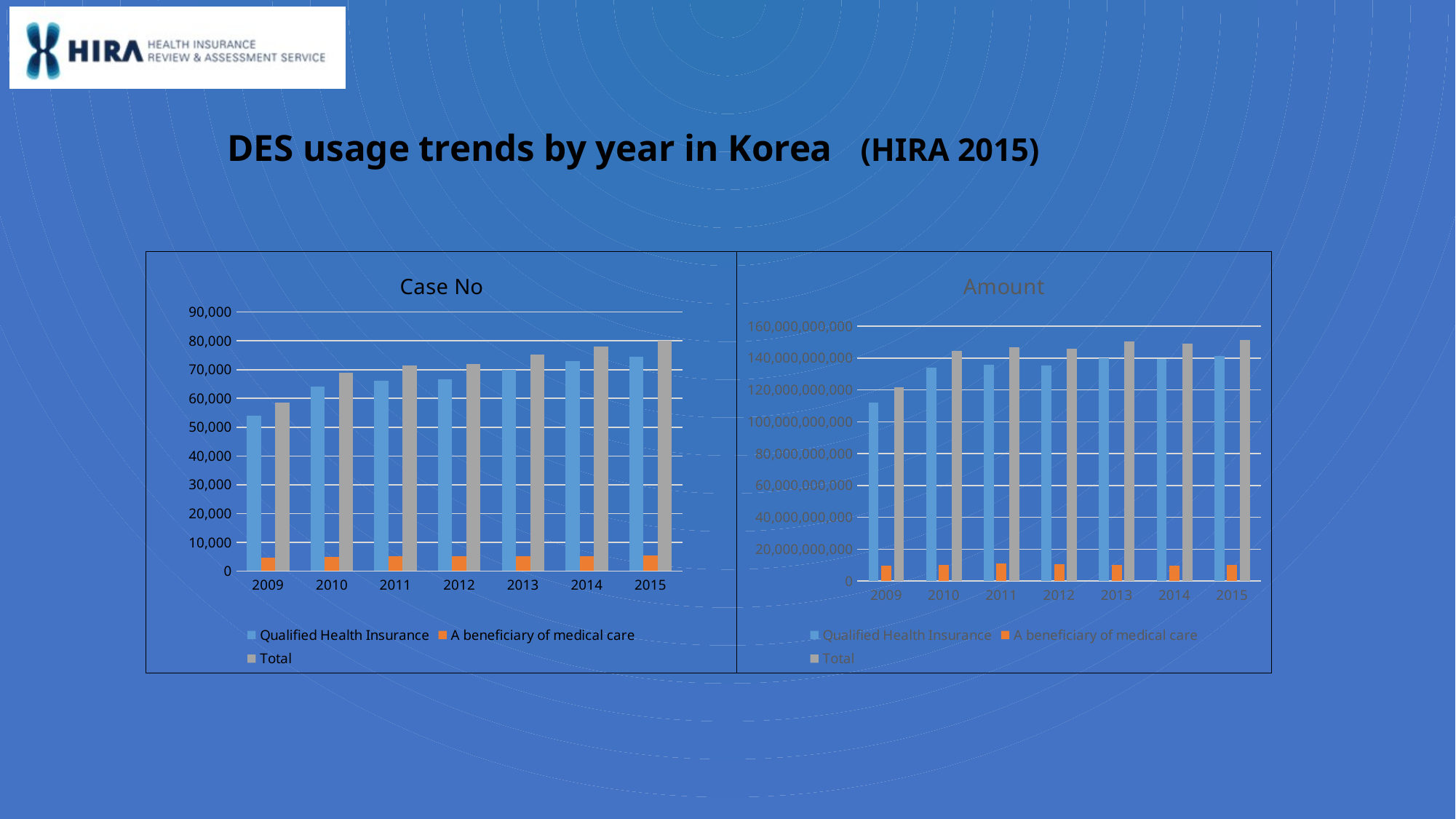
In the Case No chart, how many years are shown on the x axis? 7 In the Case No chart, is the value for A beneficiary of medical care in 2013 greater or less than 10,000? less In the Case No chart, is the Qualified Health Insurance value for 2015 greater or less than 70,000? greater In the Case No chart, how many series does the legend list? 3 In the Case No chart, does the Total rise or fall from 2009 to 2015? rise In the Case No chart, what kind of chart is shown? bar chart In the Case No chart, which year has the lowest Total? 2009 In the Amount chart, which is larger, the Qualified Health Insurance value for 2009 or for 2015? 2015 In the Amount chart, which year has the lowest Total? 2009 In the Case No chart, which year has the highest Total? 2015 In the Case No chart, is the Total for 2009 greater or less than 60,000? less